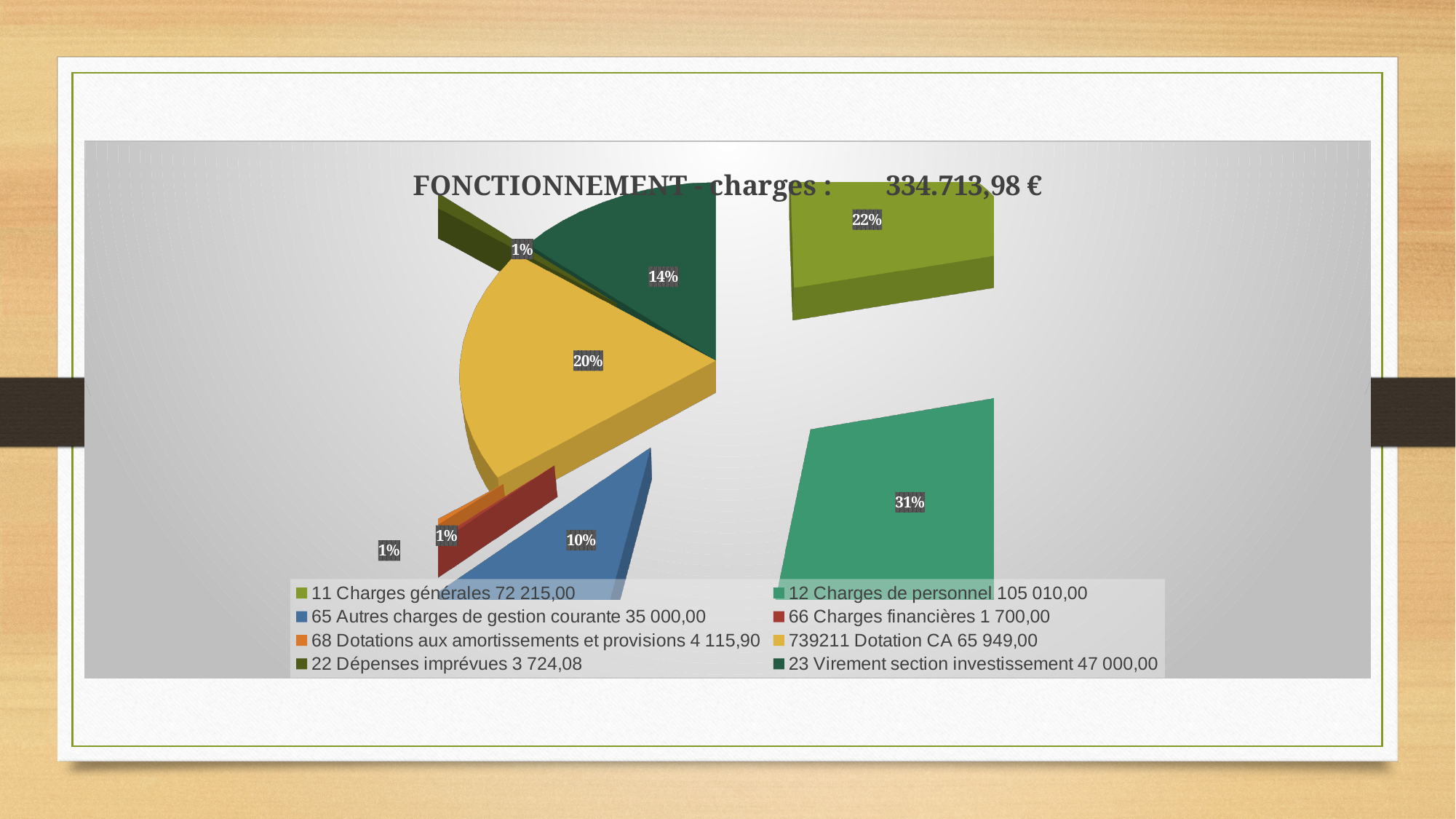
What share of the pie does '11 Charges générales' represent? 22% What share of the pie does '65 Autres charges de gestion courante' represent? 10% What type of chart is shown on the slide? pie chart According to the legend, which category has the smallest amount? 66 Charges financières Which category has the largest slice of the pie? 12 Charges de personnel What share of the pie does '23 Virement section investissement' represent? 14% Which slice is larger: '11 Charges générales' or '739211 Dotation CA'? 11 Charges générales How many categories does the pie chart have? 8 What is the difference in percentage points between the '12 Charges de personnel' slice and the '11 Charges générales' slice? 9 percentage points What total amount is shown in the chart title? 334.713,98 €